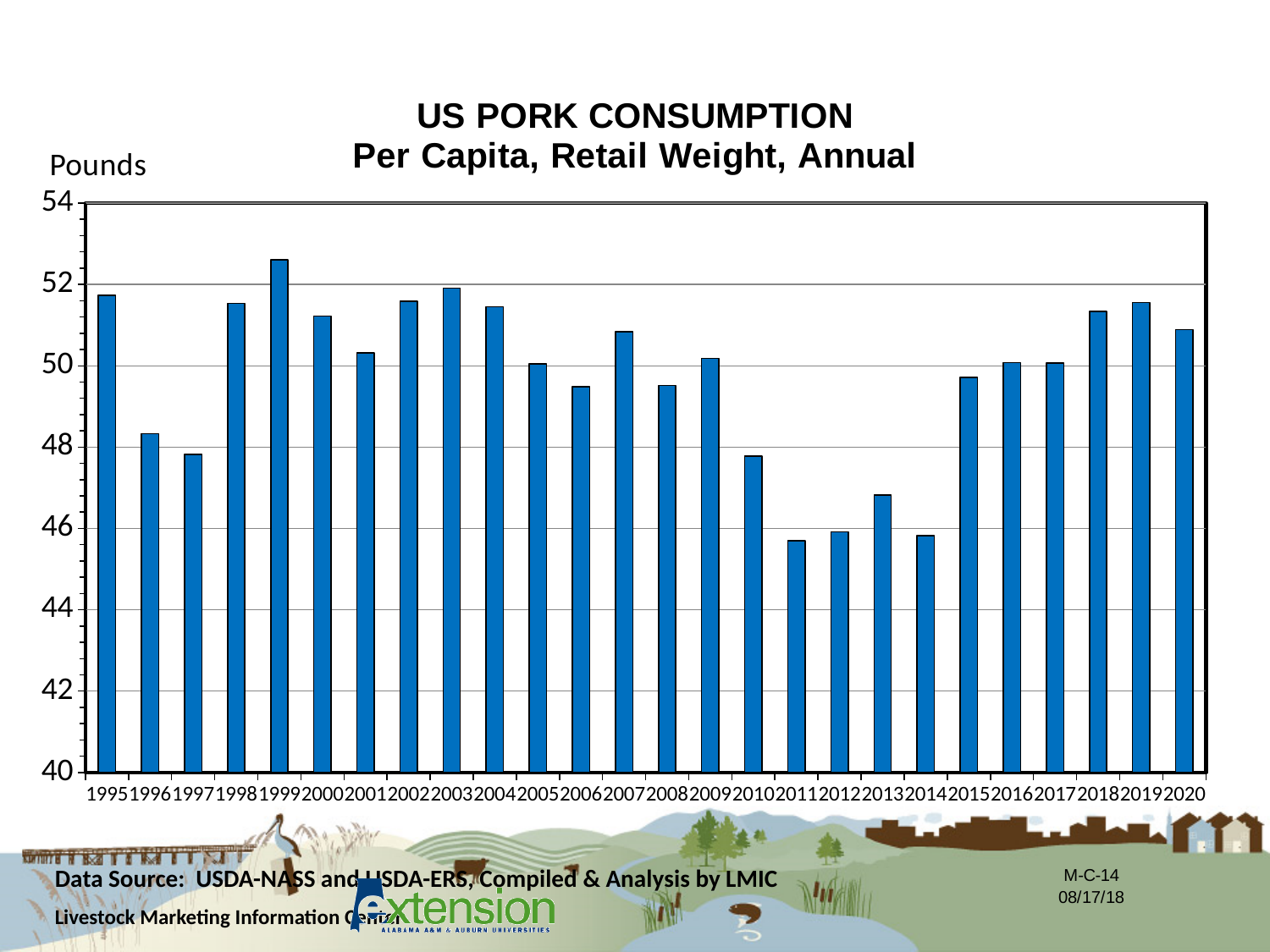
Is the value for 2010 greater or less than 48? less Which year has the larger value, 2003 or 2010? 2003 Is the value for 2007 greater or less than 50? greater Is the value for 1999 greater or less than 52? greater What kind of chart is shown on the slide? bar chart Between 2014 and 2019, do the values generally rise or fall? rise What unit is shown on the vertical axis label? Pounds How many years (bars) are plotted on the chart? 26 Which year has the highest per capita pork consumption? 1999 Which year has the larger value, 2018 or 2013? 2018